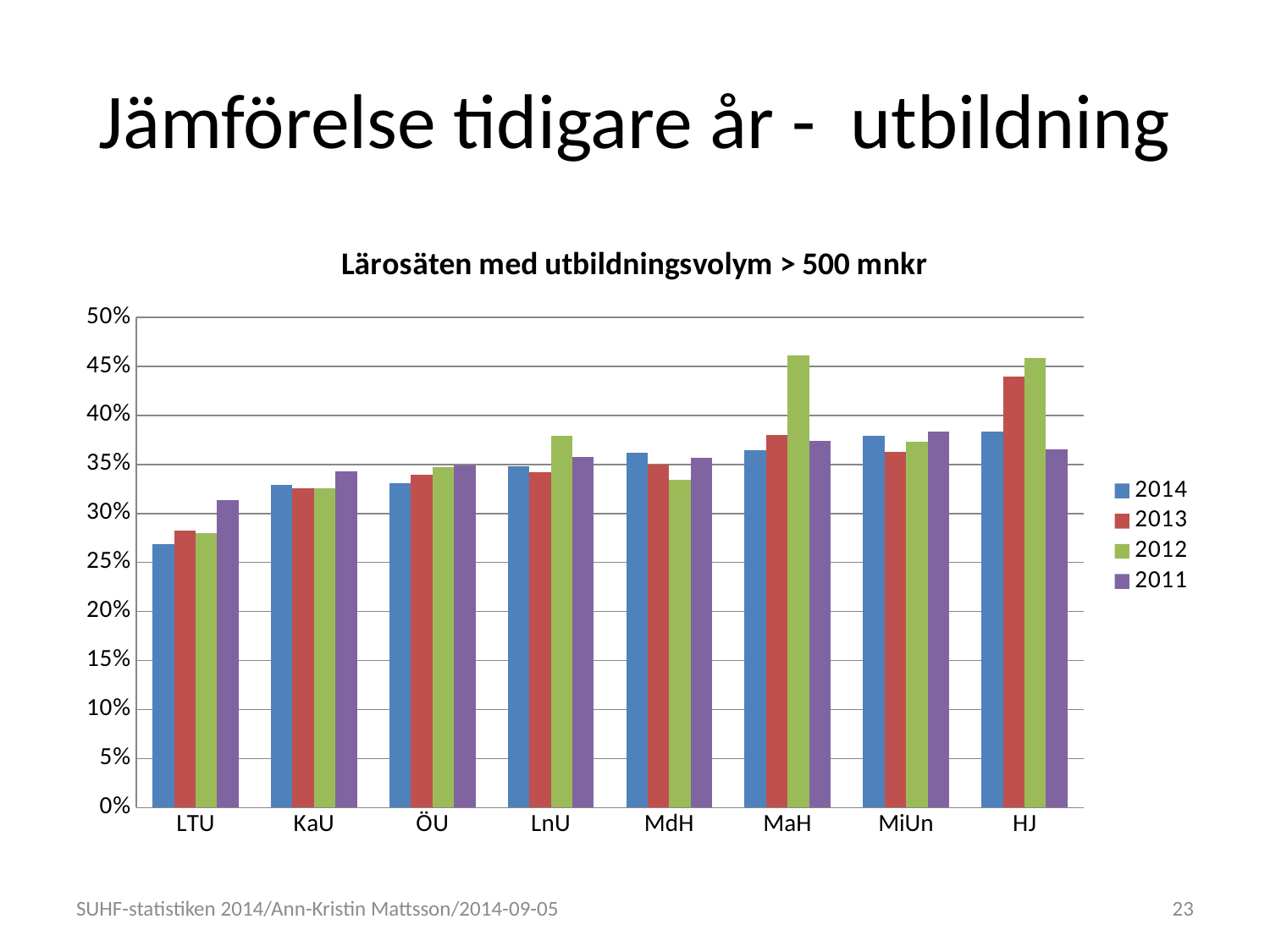
Which colour represents the 2012 series in the legend? green What is the title of the chart? Lärosäten med utbildningsvolym > 500 mnkr For LTU, which is larger: the 2014 value or the 2011 value? 2011 Is the 2013 value for HJ greater or less than 40%? greater Do the 2014 values generally rise or fall from LTU to HJ along the x axis? rise Is the 2012 value for MdH greater or less than 35%? less How many institutions (categories) are shown on the x axis? 8 How many series does the legend list? 4 What kind of chart is shown on the slide? bar chart Is the 2014 value for LTU greater or less than 30%? less Which institution has the highest 2013 value? HJ Which institution has the lowest 2014 value? LTU